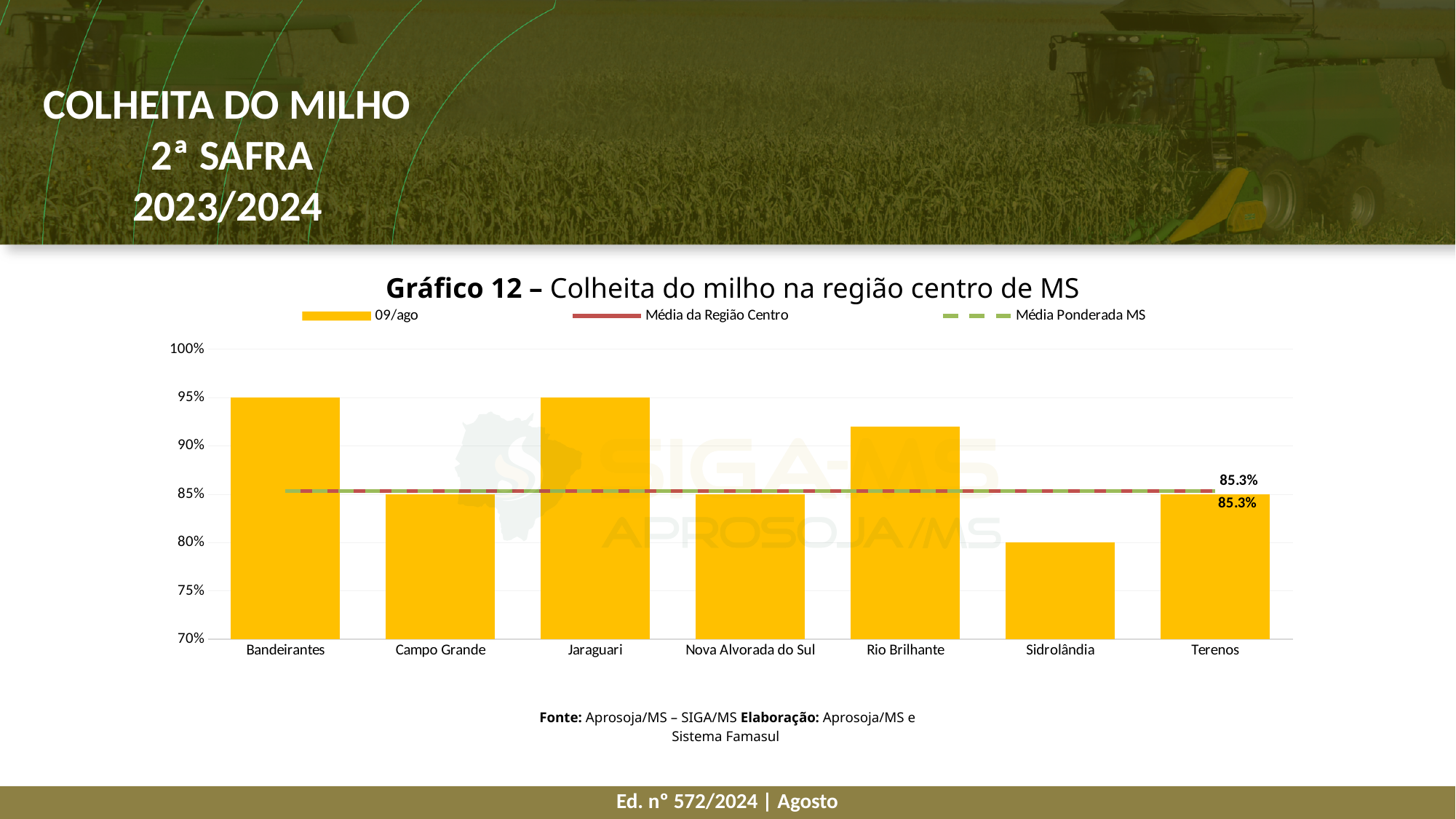
Which has a higher harvest percentage, Rio Brilhante or Sidrolândia? Rio Brilhante What is the difference between the harvest percentages of Bandeirantes and Sidrolândia? 15% Is the value for Rio Brilhante greater or less than 90%? greater What type of chart is shown on the slide? combination bar and line chart Which municipality has the lowest harvest percentage in the chart? Sidrolândia How many municipalities are shown on the x axis of the chart? 7 What is the harvest percentage for Campo Grande? 85% What is the harvest percentage for Bandeirantes? 95% How many series does the chart legend list? 3 What value is labelled for the Média da Região Centro line? 85.3% What date does the bar series in the legend refer to? 09/ago What is the harvest percentage for Sidrolândia? 80%